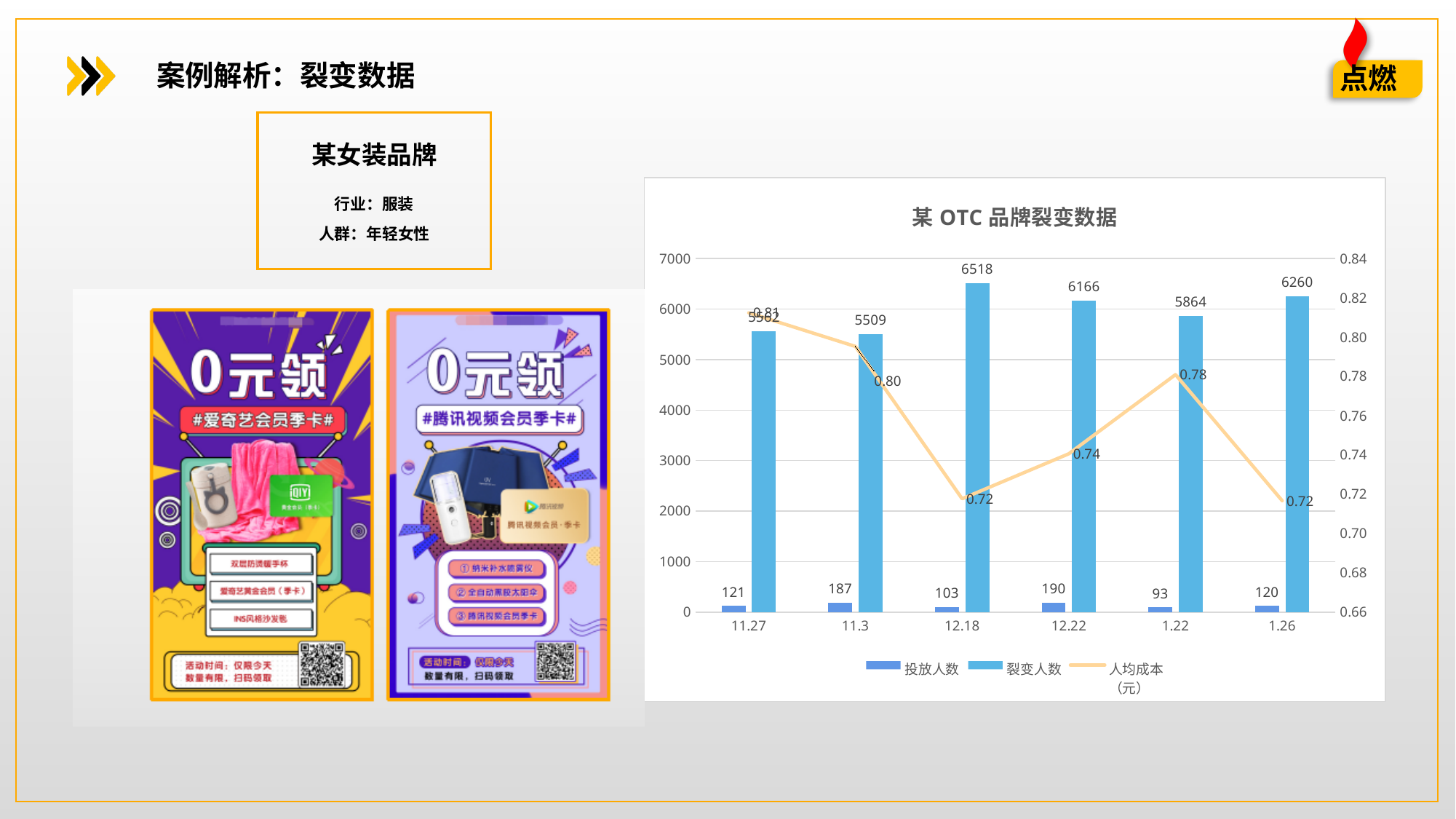
Which series is drawn as a line rather than bars? 人均成本（元） How many dates are shown on the x axis of the chart? 6 Is the 裂变人数 value for 1.22 greater or less than 5000? greater Which date has a higher 投放人数, 11.3 or 12.22? 12.22 What is the difference in 裂变人数 between 12.18 and 12.22? 352 What is the 人均成本 value for 11.27? 0.81 What is the 投放人数 value for 1.22? 93 On which date is 投放人数 the lowest? 1.22 What is the 裂变人数 value for 12.18? 6518 What is the title of the chart? 某 OTC 品牌裂变数据 On which date is 裂变人数 the highest? 12.18 How many series does the chart legend list? 3